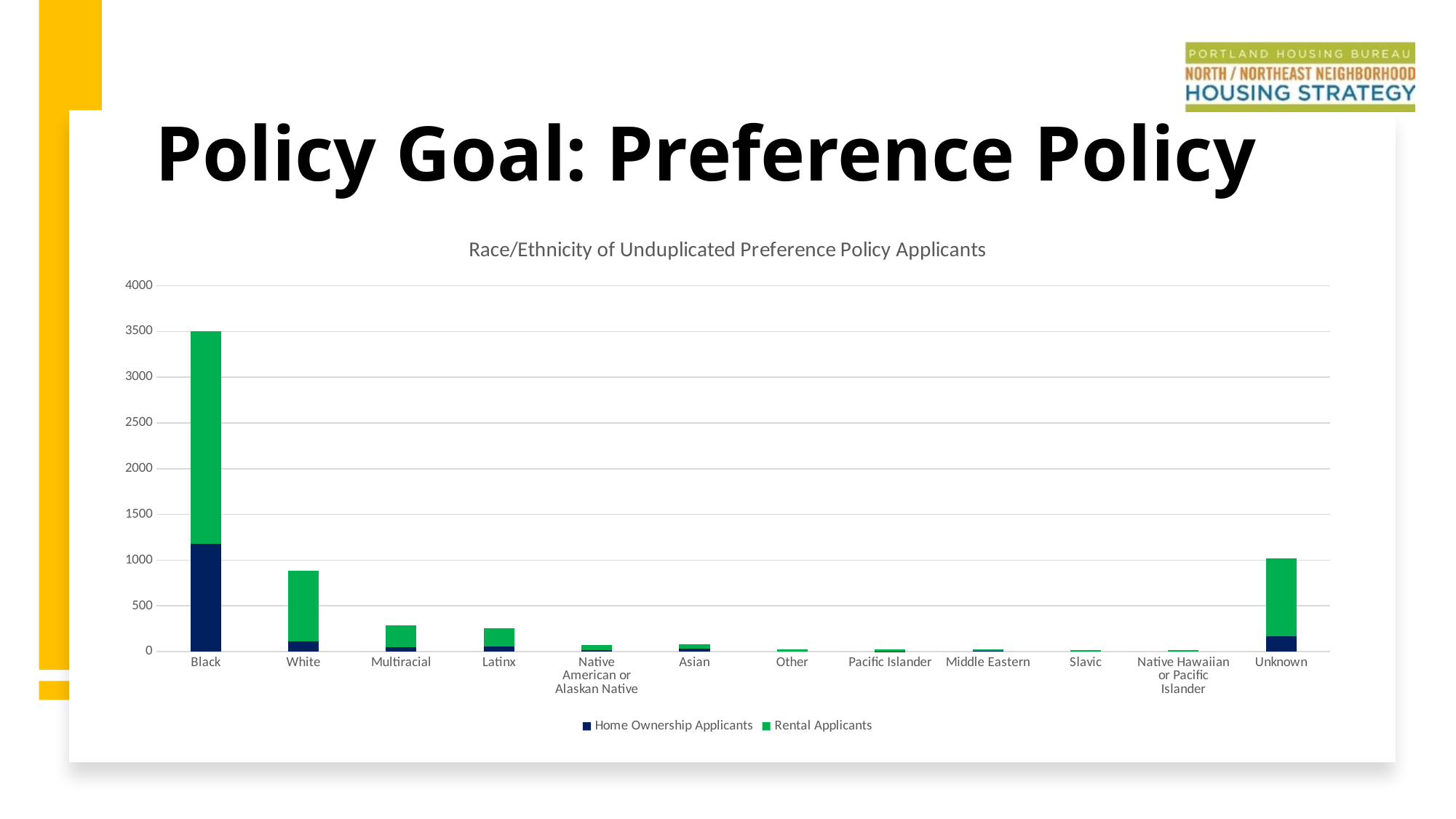
Which category has the highest total number of applicants? Black Is the total value for Unknown greater or less than 500? greater How many series does the legend list? 2 What is the title of the chart? Race/Ethnicity of Unduplicated Preference Policy Applicants What kind of chart is shown on the slide? Stacked bar chart Is the total value for Multiracial greater or less than 500? less Which colour represents Rental Applicants in the chart? Green Which has a larger total number of applicants, White or Unknown? Unknown Is the total value for Black greater or less than 3000? greater How many race/ethnicity categories are shown on the x axis? 12